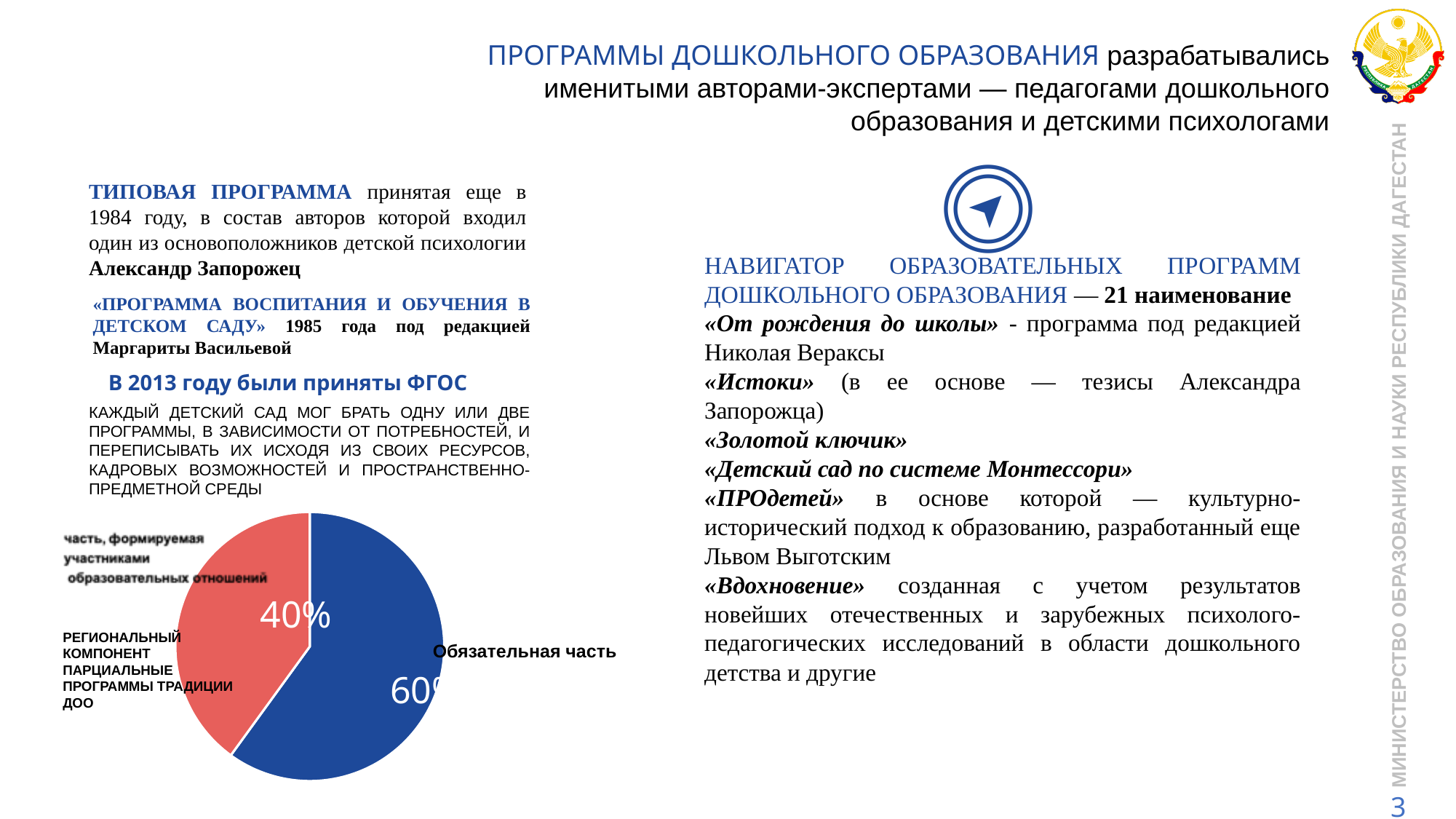
In the pie chart, which is larger: 'Обязательная часть' or 'часть, формируемая участниками образовательных отношений'? Обязательная часть What kind of chart is shown at the bottom left of the slide? pie chart What percentage is shown for the slice 'часть, формируемая участниками образовательных отношений' in the pie chart? 40% Which slice of the pie chart is the largest? Обязательная часть What colour is the slice labelled 40% in the pie chart? red What share of the pie does the red slice represent? 40% How many slices does the pie chart have? 2 What colour is the 'Обязательная часть' slice in the pie chart? blue Which slice of the pie chart is the smallest? часть, формируемая участниками образовательных отношений